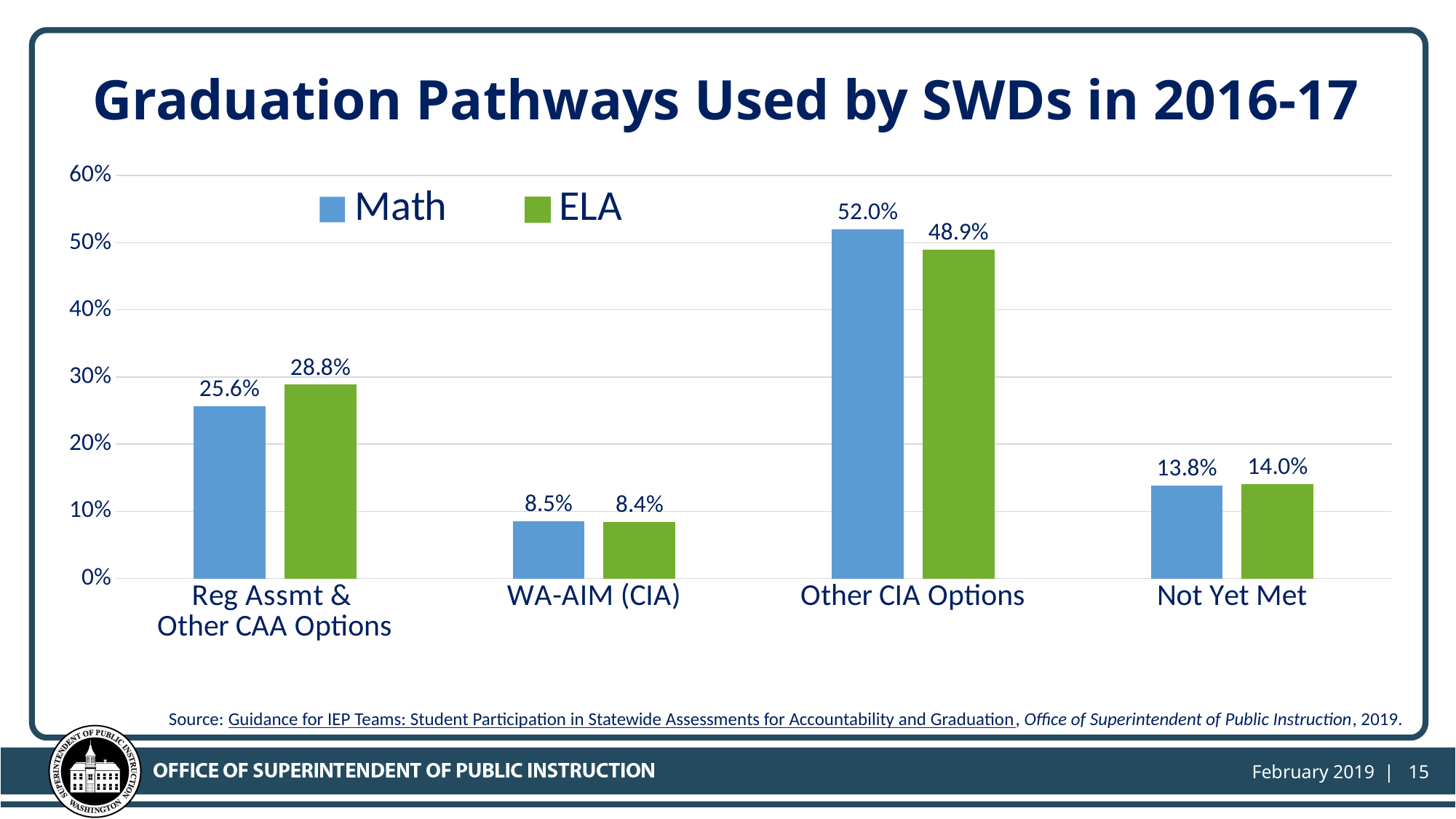
What is the ELA value for WA-AIM (CIA)? 8.4% How many categories are shown on the x axis? 4 How many series does the legend list? 2 What colour represents the ELA series? Green What is the Math value for Not Yet Met? 13.8% What is the difference between the Math and ELA values for Other CIA Options? 3.1% Which category has the highest Math value? Other CIA Options Which is larger for Reg Assmt & Other CAA Options, the Math value or the ELA value? ELA What is the Math value for Other CIA Options? 52.0% What is the ELA value for Reg Assmt & Other CAA Options? 28.8% What kind of chart is shown on the slide? Bar chart Which category has the lowest ELA value? WA-AIM (CIA)